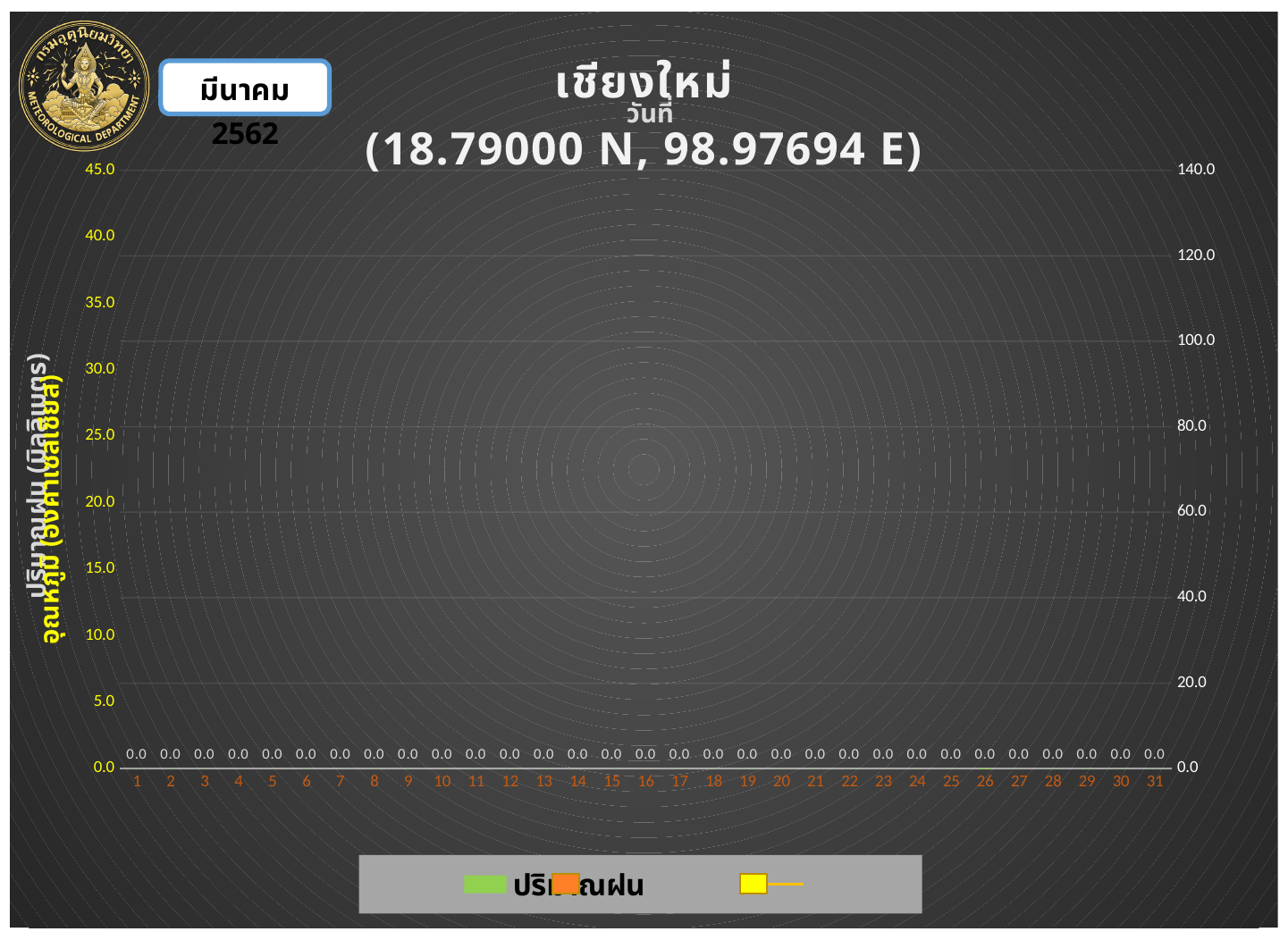
Do the labelled values rise, fall, or stay the same from day 1 to day 31? stay the same What is the data label shown for day 31 on the chart? 0.0 Is the value for day 8 greater or less than 40.0 on the right axis? less What coordinates are given in the chart title? 18.79000 N, 98.97694 E What is the highest tick value shown on the right vertical axis? 140.0 What is the difference between the values labelled for day 5 and day 10? 0.0 What is the highest tick value shown on the left vertical axis? 45.0 What is the data label shown for day 1 on the chart? 0.0 How many days are shown along the x axis of the chart? 31 What is the data label shown for day 15 on the chart? 0.0